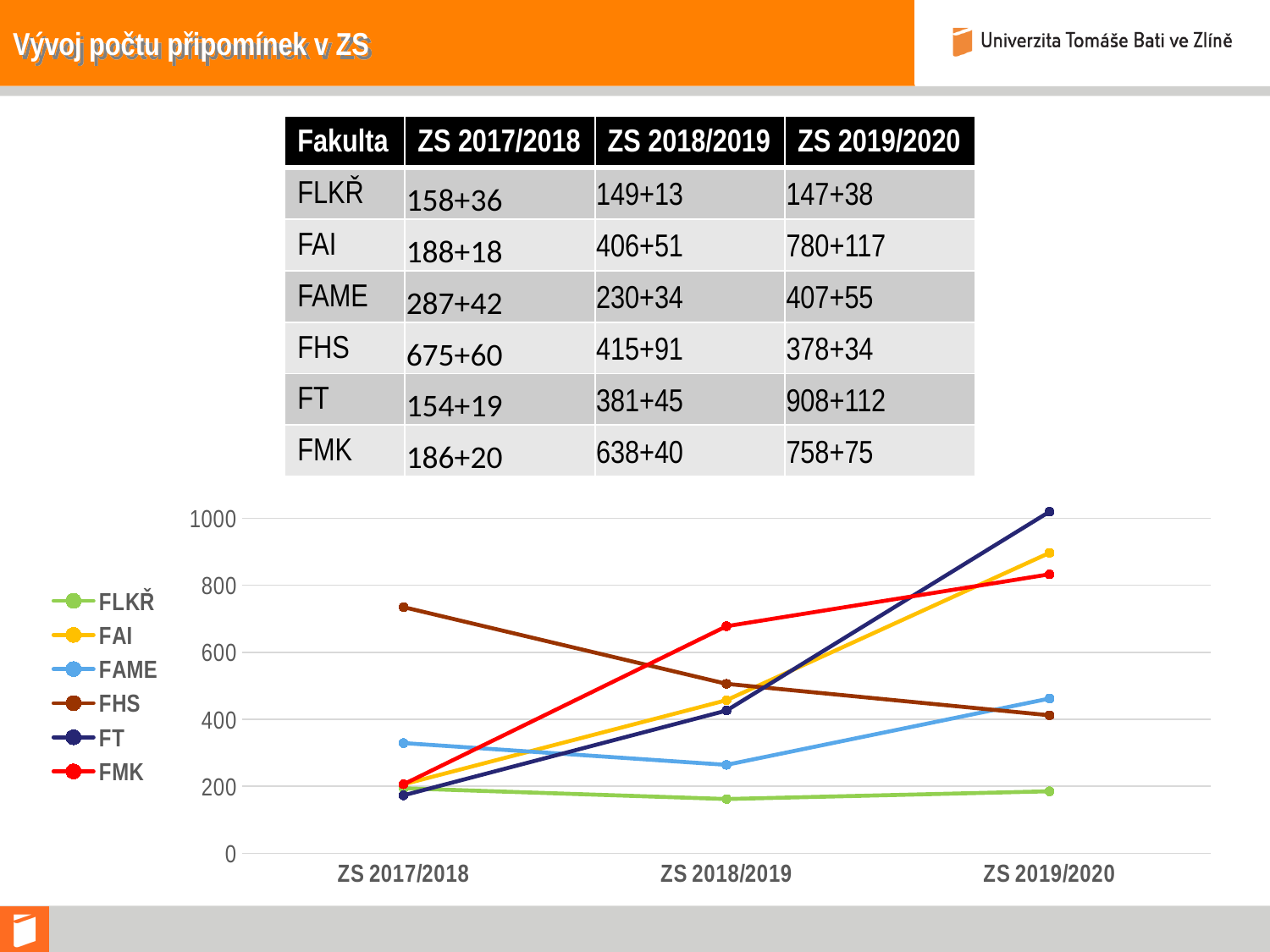
How many categories are shown on the x axis of the chart? 3 Does the FHS line rise or fall from ZS 2017/2018 to ZS 2019/2020? fall How many series does the chart's legend list? 6 Which series has the highest value at ZS 2017/2018? FHS Is the value for FMK at ZS 2018/2019 greater or less than 600? greater Which is larger at ZS 2018/2019, the value for FHS or the value for FAME? FHS Does the FT line rise or fall from ZS 2017/2018 to ZS 2019/2020? rise Which series has the highest value at ZS 2019/2020? FT Which series has the lowest value at ZS 2019/2020? FLKŘ Is the value for FAME at ZS 2018/2019 greater or less than 400? less What kind of chart is shown on the slide? line chart Which series has the lowest value at ZS 2018/2019? FLKŘ